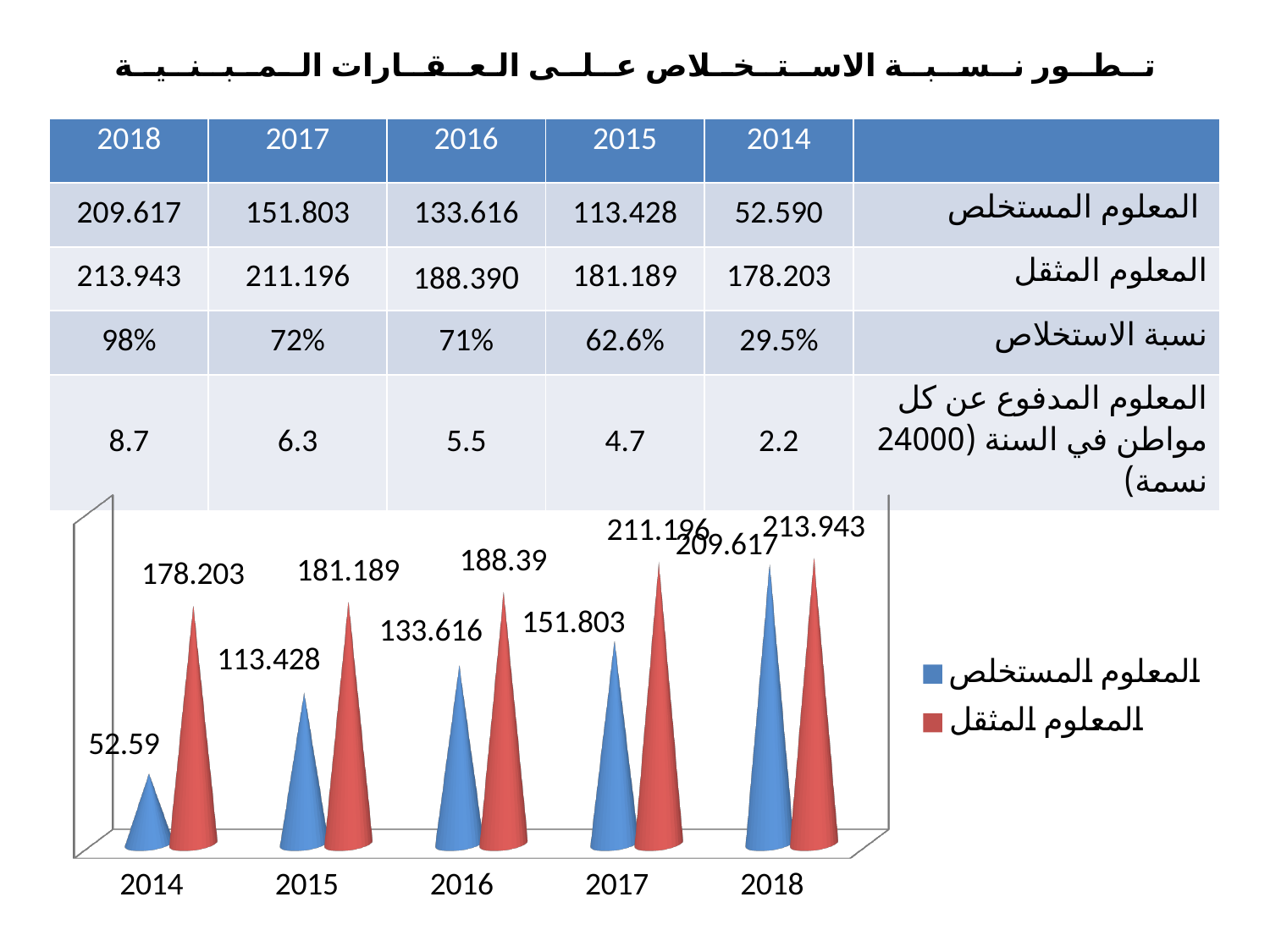
What is the value of المعلوم المستخلص for 2014 in the chart? 52.59 How many years are shown on the x axis of the chart? 5 What is the difference between المعلوم المثقل and المعلوم المستخلص for 2015 in the chart? 67.761 What kind of chart is shown on the slide? bar chart How many series does the chart legend list? 2 Which year has the highest value for المعلوم المستخلص in the chart? 2018 What is the value of المعلوم المثقل for 2016 in the chart? 188.39 What is the value of المعلوم المستخلص for 2017 in the chart? 151.803 Does the value of المعلوم المستخلص rise or fall from 2014 to 2018 in the chart? rise Which colour represents المعلوم المثقل in the chart? red In the chart, which is larger for 2018: المعلوم المستخلص or المعلوم المثقل? المعلوم المثقل Which year has the lowest value for المعلوم المثقل in the chart? 2014